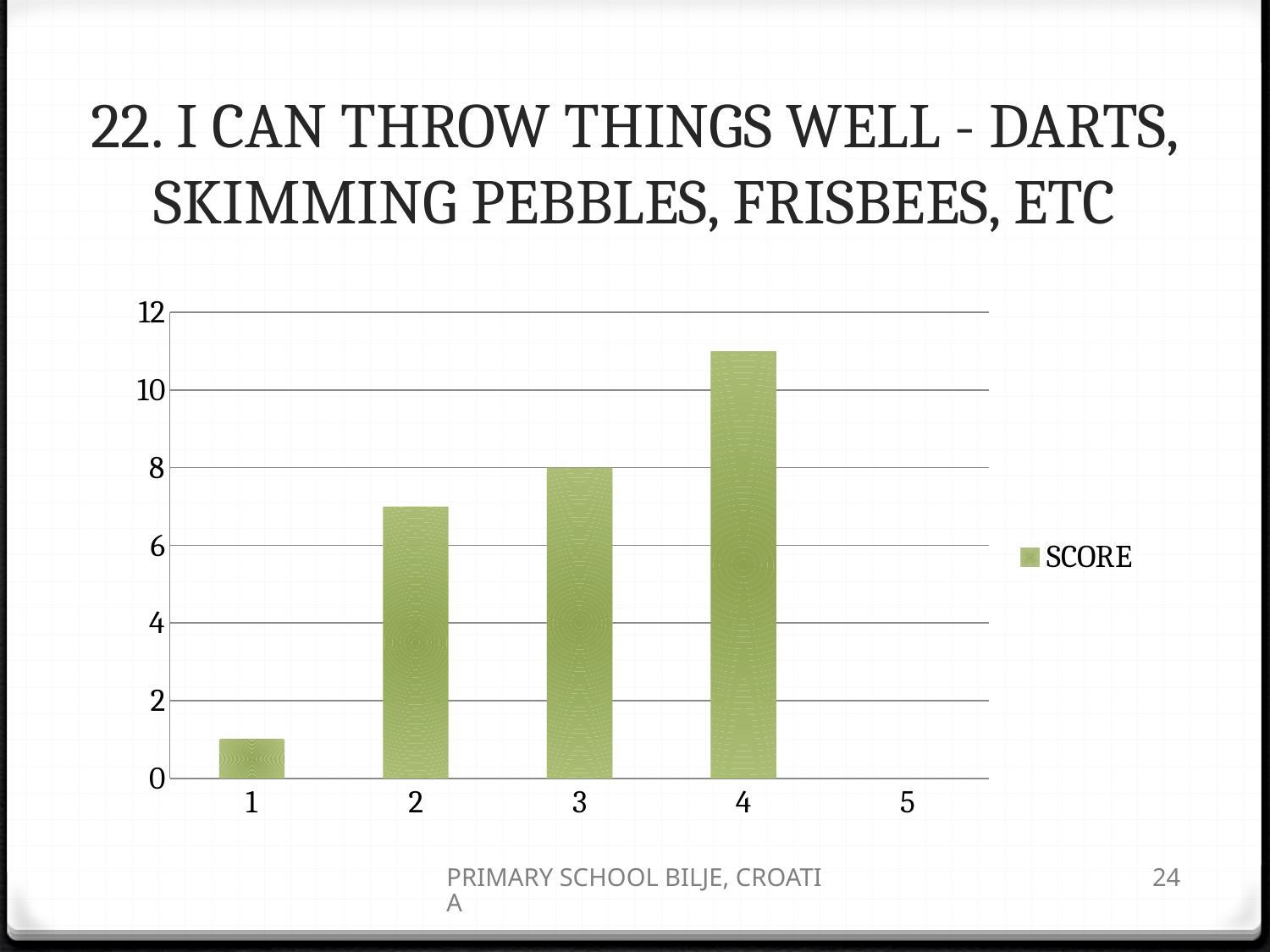
How many categories are shown on the x axis? 5 Which category has the highest score? 4 What kind of chart is shown on the slide? bar chart Which has the larger score, category 1 or category 4? category 4 What is the score for category 3? 8 How many series does the legend list? 1 Which has the larger score, category 2 or category 3? category 3 Is the score for category 4 greater or less than 10? greater Is the score for category 2 greater or less than 8? less Is the score for category 1 greater or less than 2? less What is the name of the series shown in the legend? SCORE